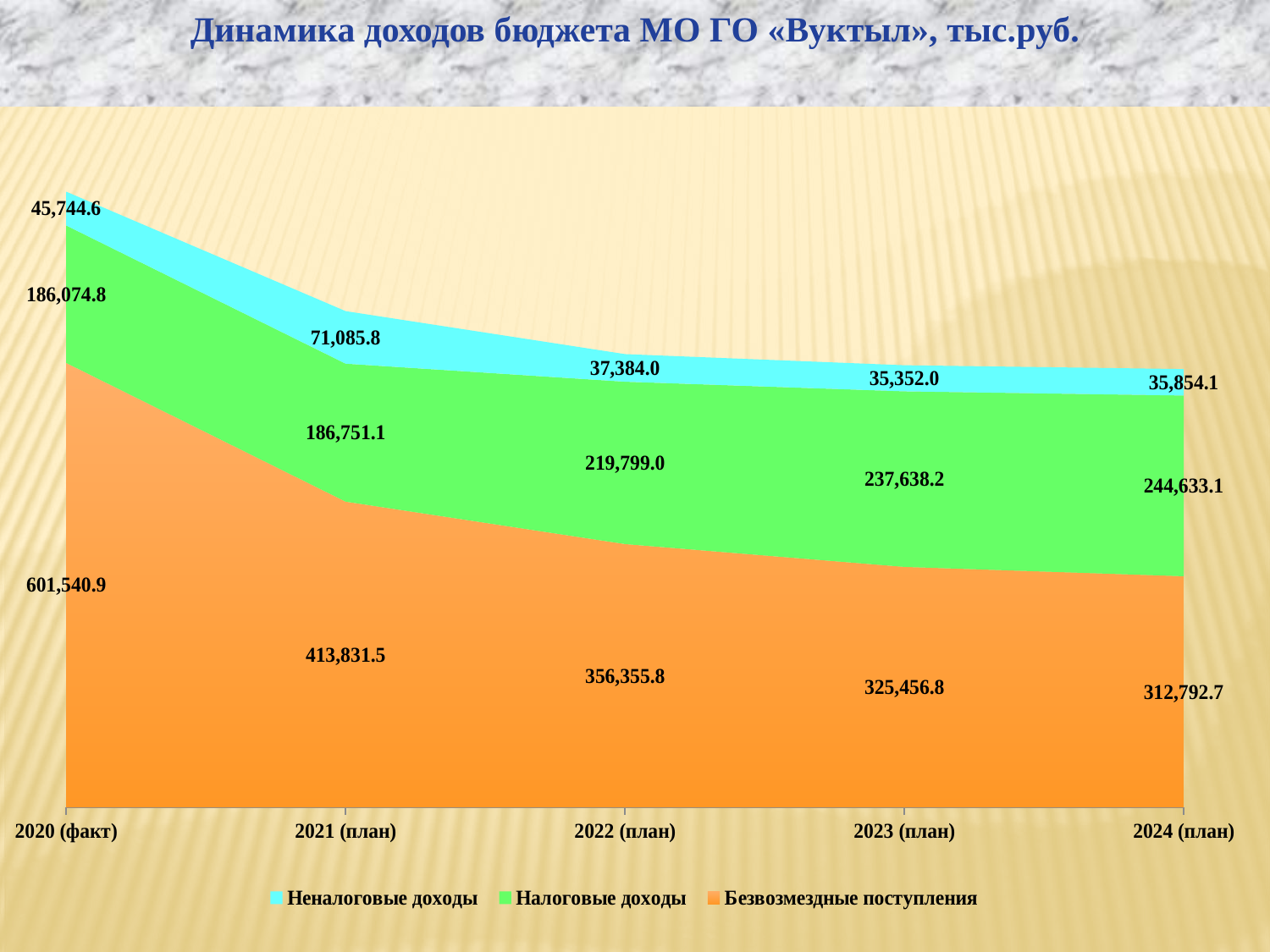
In which year is the value of Неналоговые доходы the highest? 2021 (план) What is the difference between Безвозмездные поступления in 2020 (факт) and 2021 (план)? 187,709.4 What type of chart is shown on the slide? Area chart What is the value of Налоговые доходы for 2023 (план)? 237,638.2 What is the total of all three series for 2024 (план)? 593,279.9 How many series does the legend list? 3 How many categories are shown on the x axis? 5 Do the values of Налоговые доходы rise or fall from 2020 (факт) to 2024 (план)? Rise Which is larger: Налоговые доходы in 2024 (план) or Налоговые доходы in 2022 (план)? 2024 (план) What is the value of Безвозмездные поступления for 2020 (факт)? 601,540.9 In which year is the value of Безвозмездные поступления the lowest? 2024 (план) What is the value of Неналоговые доходы for 2022 (план)? 37,384.0